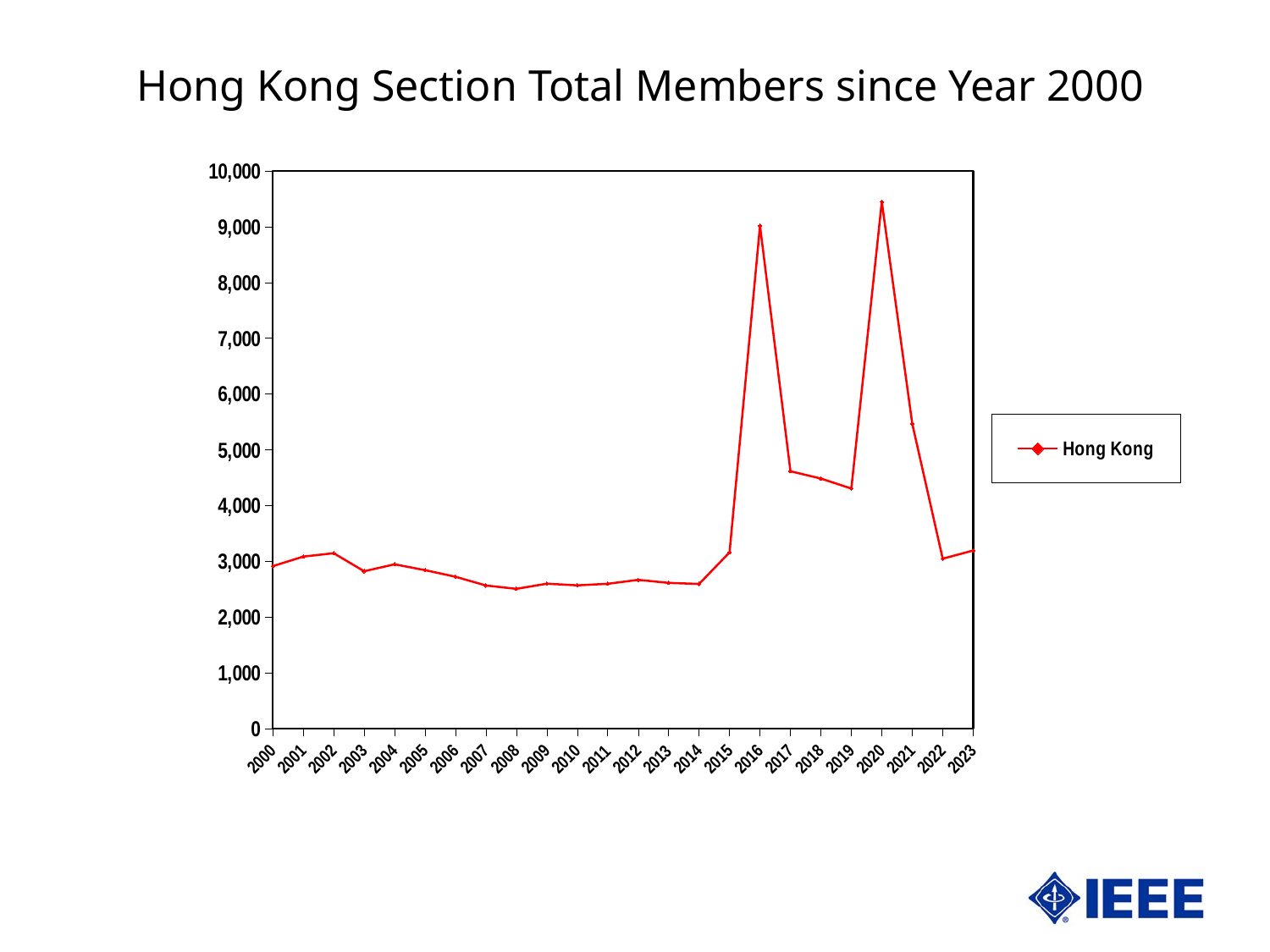
Is the value for 2020 greater or less than 9,000? greater In which year is the number of Hong Kong members highest? 2020 Which year has the larger value, 2016 or 2017? 2016 Do the values rise or fall from 2016 to 2019? fall Is the value for 2016 greater or less than 8,000? greater What is the title of the chart? Hong Kong Section Total Members since Year 2000 Is the value for 2008 greater or less than 3,000? less How many years are plotted along the x axis? 24 How many series does the legend list? 1 What kind of chart is shown on the slide? line chart